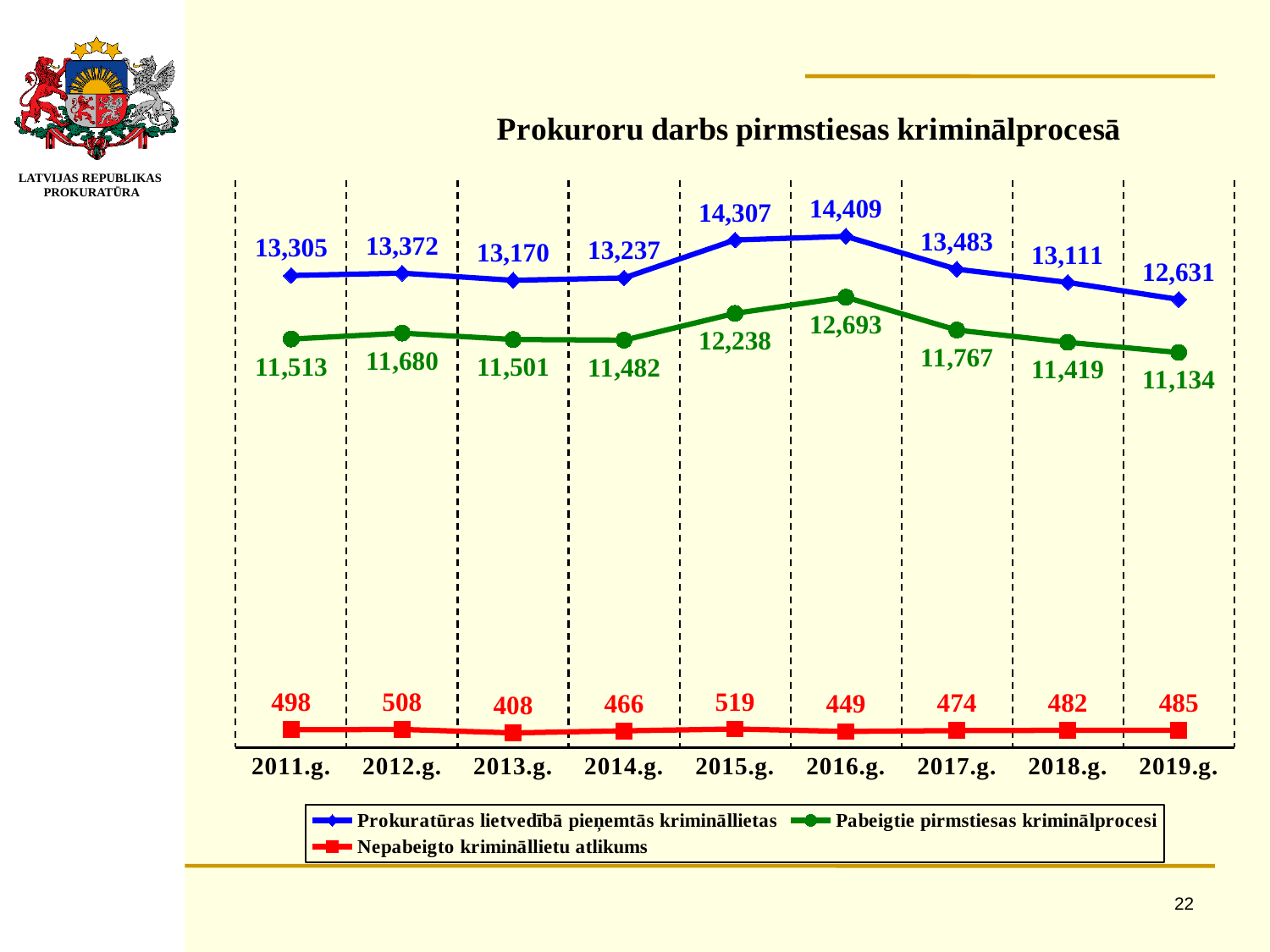
What is the difference between the highest and lowest values of Nepabeigto krimināllietu atlikums? 111 What is the value of Prokuratūras lietvedībā pieņemtās krimināllietas in 2016.g.? 14,409 How many series does the legend list? 3 In which year is Nepabeigto krimināllietu atlikums highest? 2015.g. What is the value of Nepabeigto krimināllietu atlikums in 2012.g.? 508 What is the difference between Prokuratūras lietvedībā pieņemtās krimināllietas and Pabeigtie pirmstiesas kriminālprocesi in 2016.g.? 1,716 How many years are shown on the x axis? 9 Which is larger: Pabeigtie pirmstiesas kriminālprocesi in 2012.g. or in 2017.g.? 2017.g. In which year is Nepabeigto krimināllietu atlikums lowest? 2013.g. What is the value of Pabeigtie pirmstiesas kriminālprocesi in 2014.g.? 11,482 What kind of chart is shown on the slide? Line chart In which year is Prokuratūras lietvedībā pieņemtās krimināllietas lowest? 2019.g.